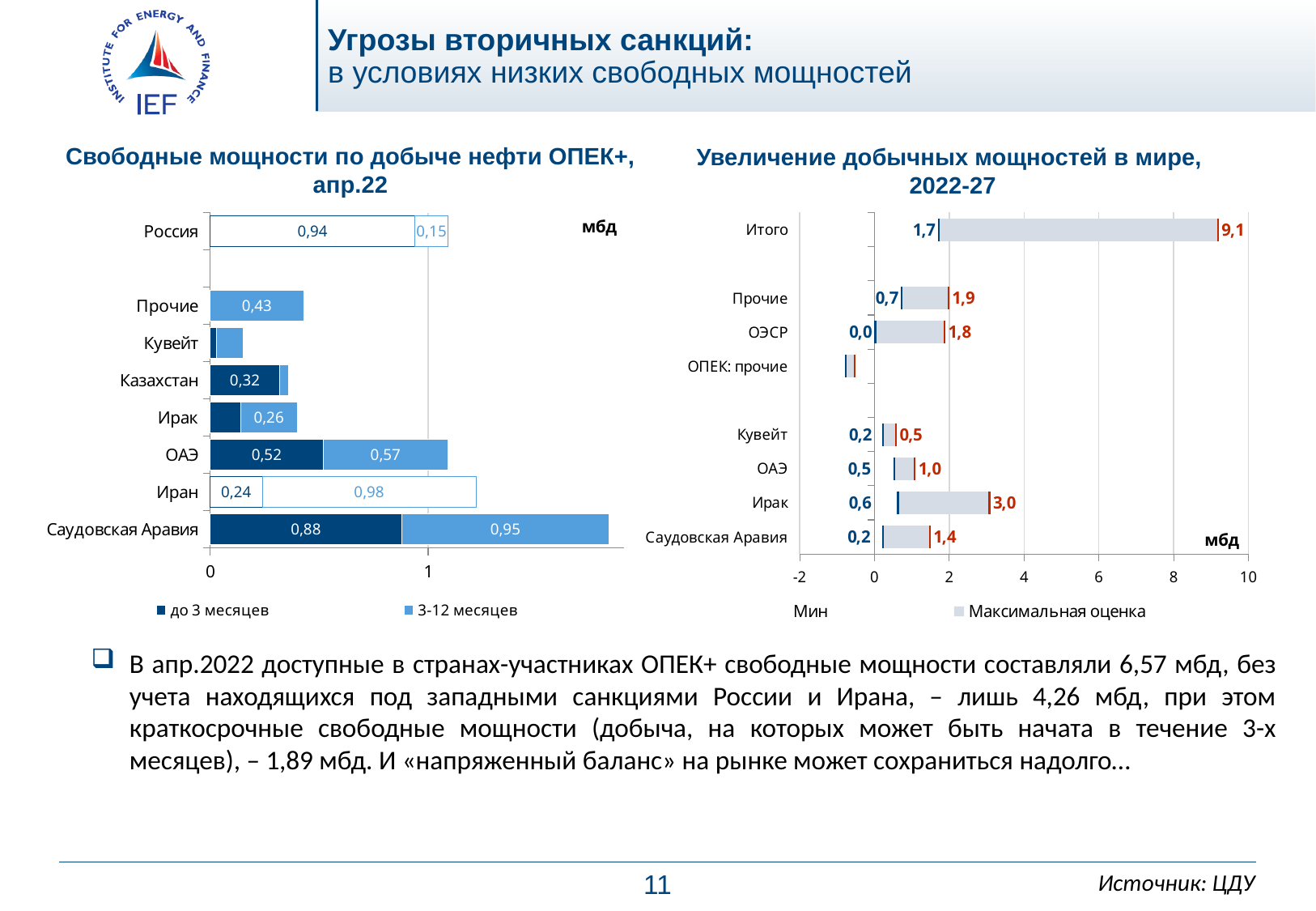
In the chart 'Свободные мощности по добыче нефти ОПЕК+, апр.22', what is the value for Саудовская Аравия in the 'до 3 месяцев' series? 0,88 In the chart 'Свободные мощности по добыче нефти ОПЕК+, апр.22', what is the value for Иран in the '3-12 месяцев' series? 0,98 In the chart 'Увеличение добычных мощностей в мире, 2022-27', what is the 'Максимальная оценка' value for Ирак? 3,0 In the chart 'Увеличение добычных мощностей в мире, 2022-27', what is the 'Мин' value for Итого? 1,7 In the chart 'Свободные мощности по добыче нефти ОПЕК+, апр.22', which category has the longest total bar? Саудовская Аравия In the chart 'Свободные мощности по добыче нефти ОПЕК+, апр.22', what is the total of the stacked bar for ОАЭ? 1,09 In the chart 'Свободные мощности по добыче нефти ОПЕК+, апр.22', what is the difference between the 'до 3 месяцев' values for Россия and Казахстан? 0,62 In the chart 'Увеличение добычных мощностей в мире, 2022-27', which has the larger 'Максимальная оценка' value, ОАЭ or Саудовская Аравия? Саудовская Аравия How many series does the legend of the chart 'Свободные мощности по добыче нефти ОПЕК+, апр.22' list? 2 In the chart 'Увеличение добычных мощностей в мире, 2022-27', what is the difference between the 'Максимальная оценка' and 'Мин' values for Итого? 7,4 What kind of chart is 'Свободные мощности по добыче нефти ОПЕК+, апр.22'? Bar chart How many categories are shown on the y axis of the chart 'Увеличение добычных мощностей в мире, 2022-27'? 8